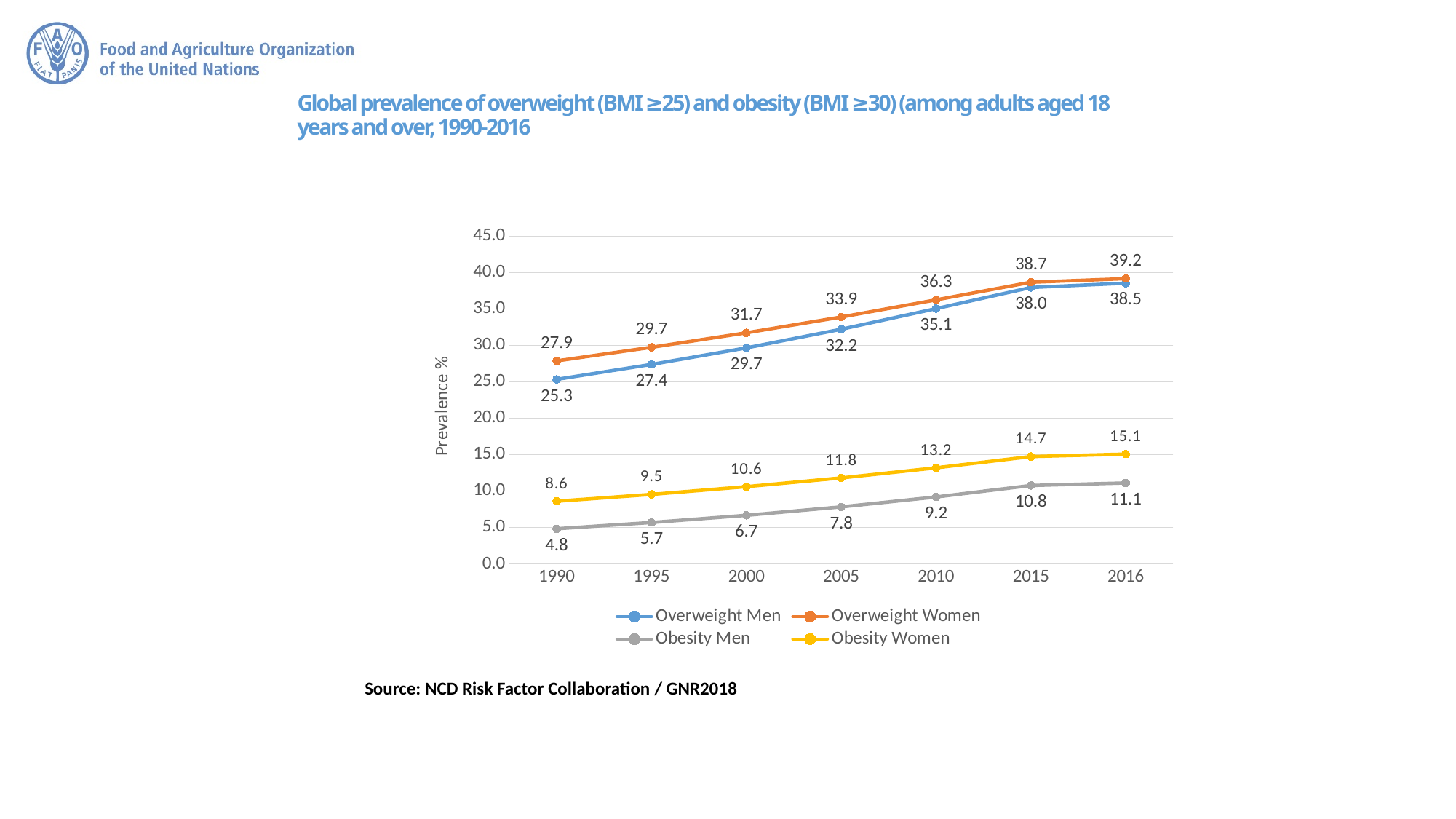
What kind of chart is shown on the slide? Line chart What is the difference between Overweight Women and Overweight Men in 1990? 2.6 What is the value for Overweight Men in 2010? 35.1 Does the Obesity Men series rise or fall from 1990 to 2016? Rise How many series does the legend list? 4 What is the value for Obesity Men in 1990? 4.8 In which year is the Obesity Women series at its highest? 2016 In which year is the Overweight Men series at its lowest? 1990 What is the value for Obesity Women in 2005? 11.8 What is the value for Overweight Women in 2016? 39.2 How many years are shown on the x axis? 7 Which is larger in 2015: Obesity Women or Obesity Men? Obesity Women